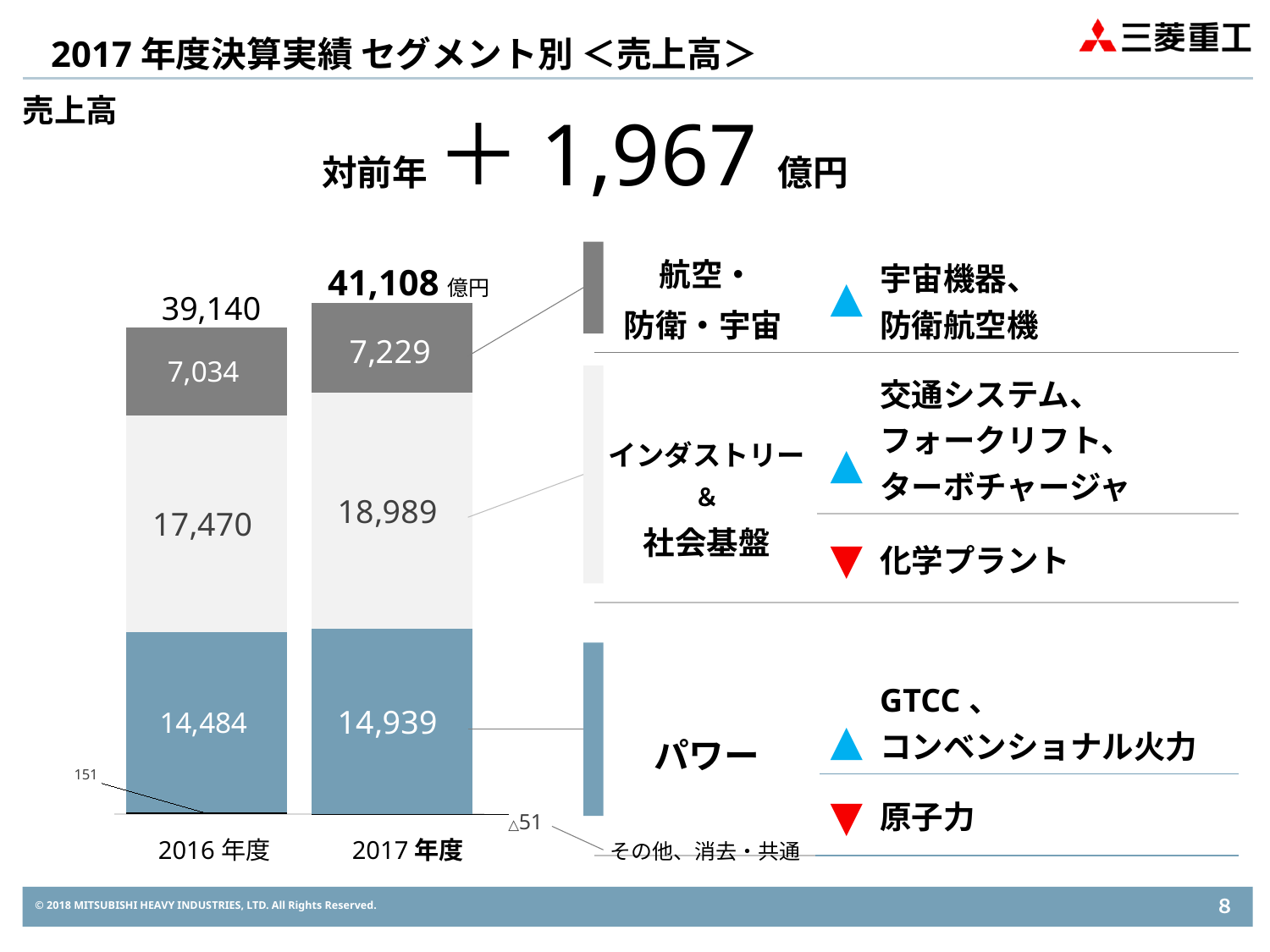
What is the value of the 航空・防衛・宇宙 segment in 2017 年度? 7,229 What is the value of the パワー segment in 2017 年度? 14,939 Is the 航空・防衛・宇宙 segment larger in 2016 年度 or 2017 年度? 2017 年度 Which segment is the largest in the 2017 年度 bar? インダストリー＆社会基盤 Which segment is the smallest in the 2016 年度 bar? その他、消去・共通 By how much did the パワー segment change from 2016 年度 to 2017 年度? 455 What is the total 売上高 for 2016 年度? 39,140 How many fiscal years (bars) are shown in the chart? 2 What is the value of the インダストリー＆社会基盤 segment in 2016 年度? 17,470 What is the total 売上高 for 2017 年度? 41,108 億円 What is the value of その他、消去・共通 in 2017 年度? △51 What type of chart is shown on the slide? stacked bar chart